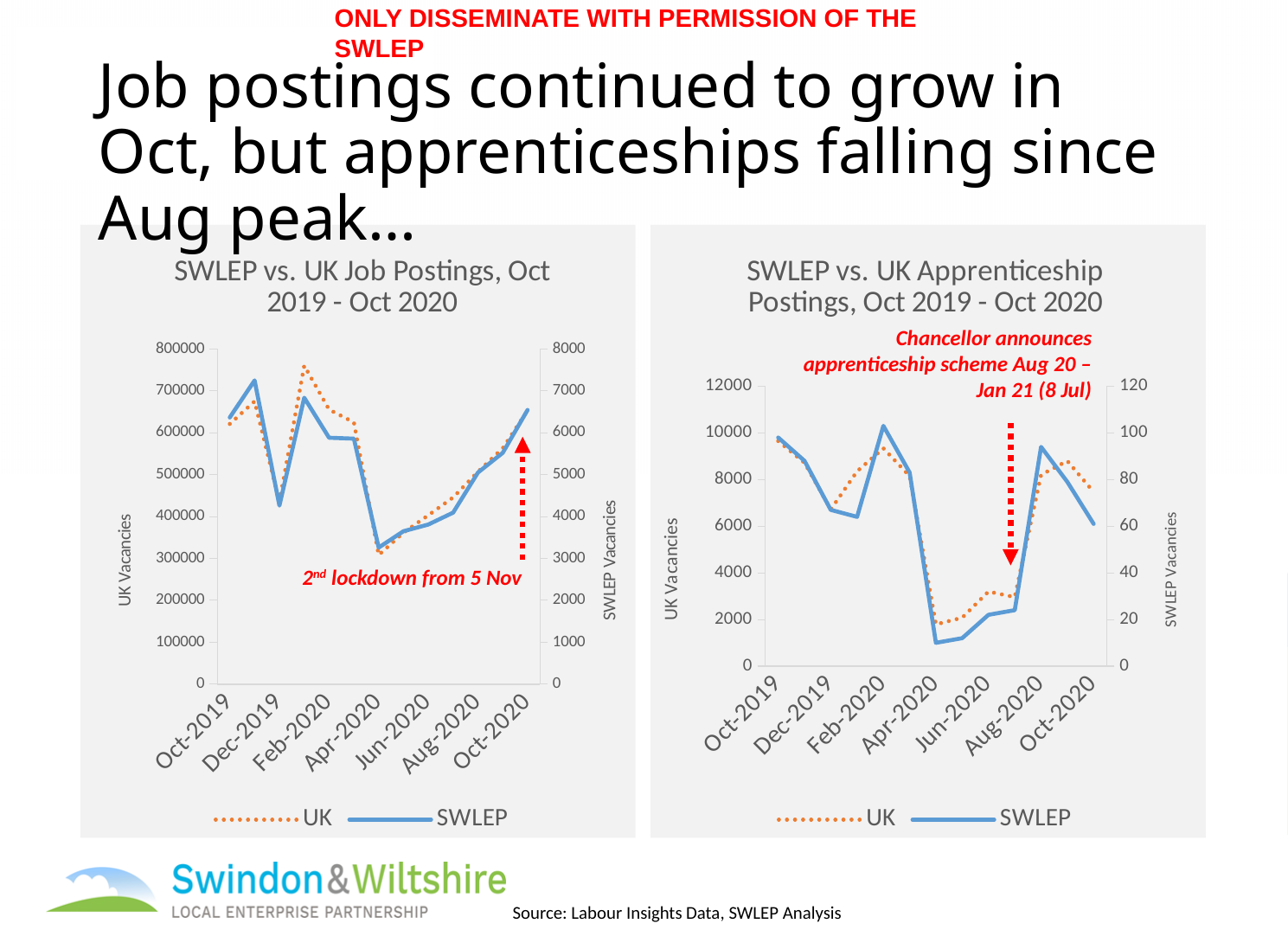
In the right chart, 'SWLEP vs. UK Apprenticeship Postings', is the SWLEP value for Apr-2020 greater or less than 20 on the SWLEP Vacancies axis? less In the left chart, 'SWLEP vs. UK Job Postings', does the SWLEP line rise or fall from Apr-2020 to Oct-2020? Rise In the right chart, 'SWLEP vs. UK Apprenticeship Postings', does the SWLEP line rise or fall from Aug-2020 to Oct-2020? Fall In the right chart, 'SWLEP vs. UK Apprenticeship Postings', is the UK value for Oct-2019 greater or less than 8000 on the UK Vacancies axis? greater In the left chart, 'SWLEP vs. UK Job Postings', is the SWLEP value for Oct-2020 greater or less than 6000 on the SWLEP Vacancies axis? greater What kind of chart is the left chart, 'SWLEP vs. UK Job Postings, Oct 2019 - Oct 2020'? Line chart In the left chart, which series is drawn as a dotted line? UK How many series does the legend of the right chart, 'SWLEP vs. UK Apprenticeship Postings', list? 2 What is the title of the right chart? SWLEP vs. UK Apprenticeship Postings, Oct 2019 - Oct 2020